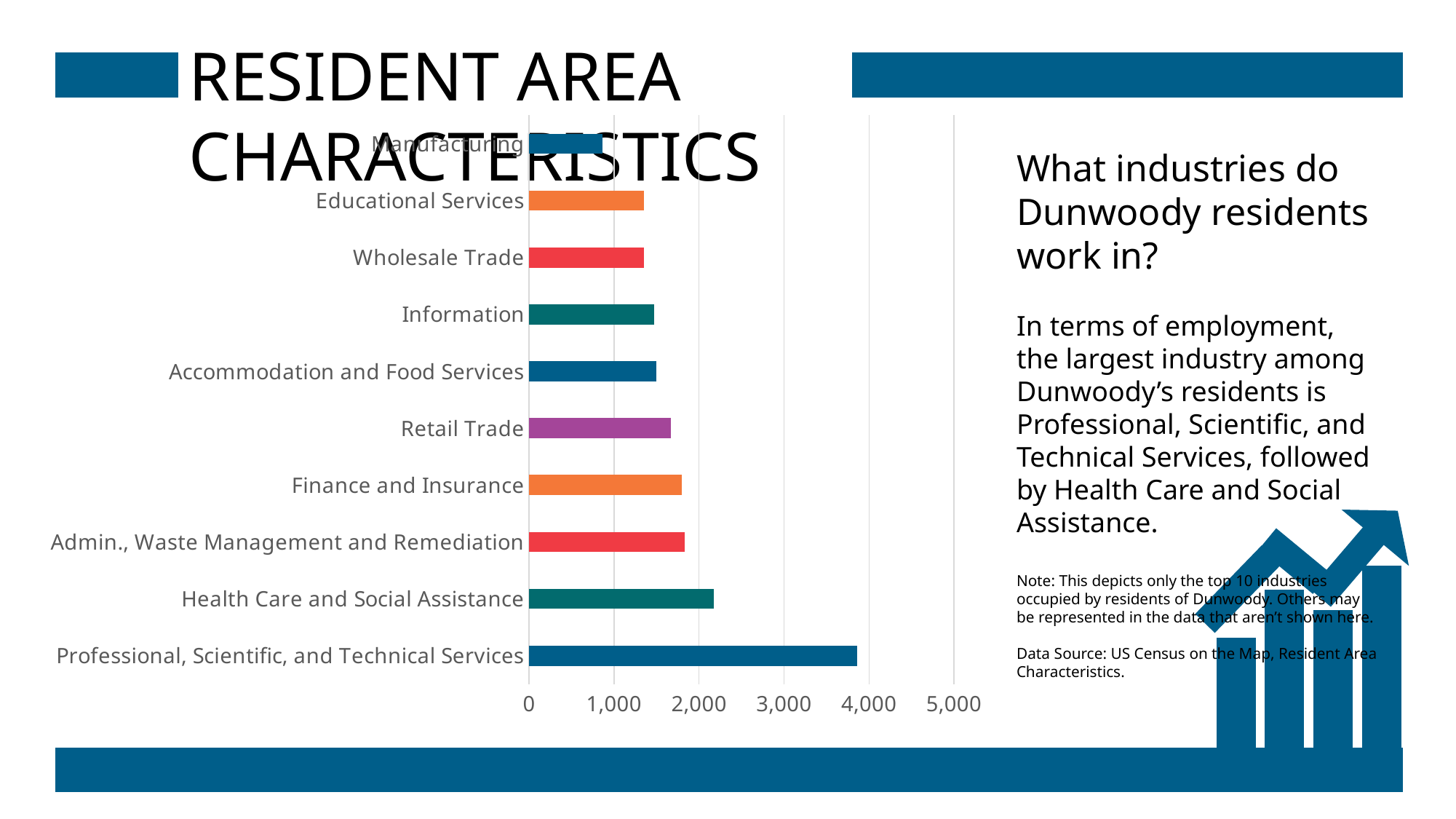
Which industry has the longest bar in the chart? Professional, Scientific, and Technical Services Is the value for Finance and Insurance greater or less than 2,000? less Which is larger, the value for Manufacturing or the value for Information? Information Is the value for Manufacturing greater or less than 1,000? less Which industry has the shortest bar in the chart? Manufacturing How many industries are plotted in the chart? 10 Which is larger, the value for Health Care and Social Assistance or the value for Retail Trade? Health Care and Social Assistance Is the value for Professional, Scientific, and Technical Services greater or less than 3,000? greater What kind of chart is shown on the slide? bar chart What colour is the bar for Retail Trade? purple